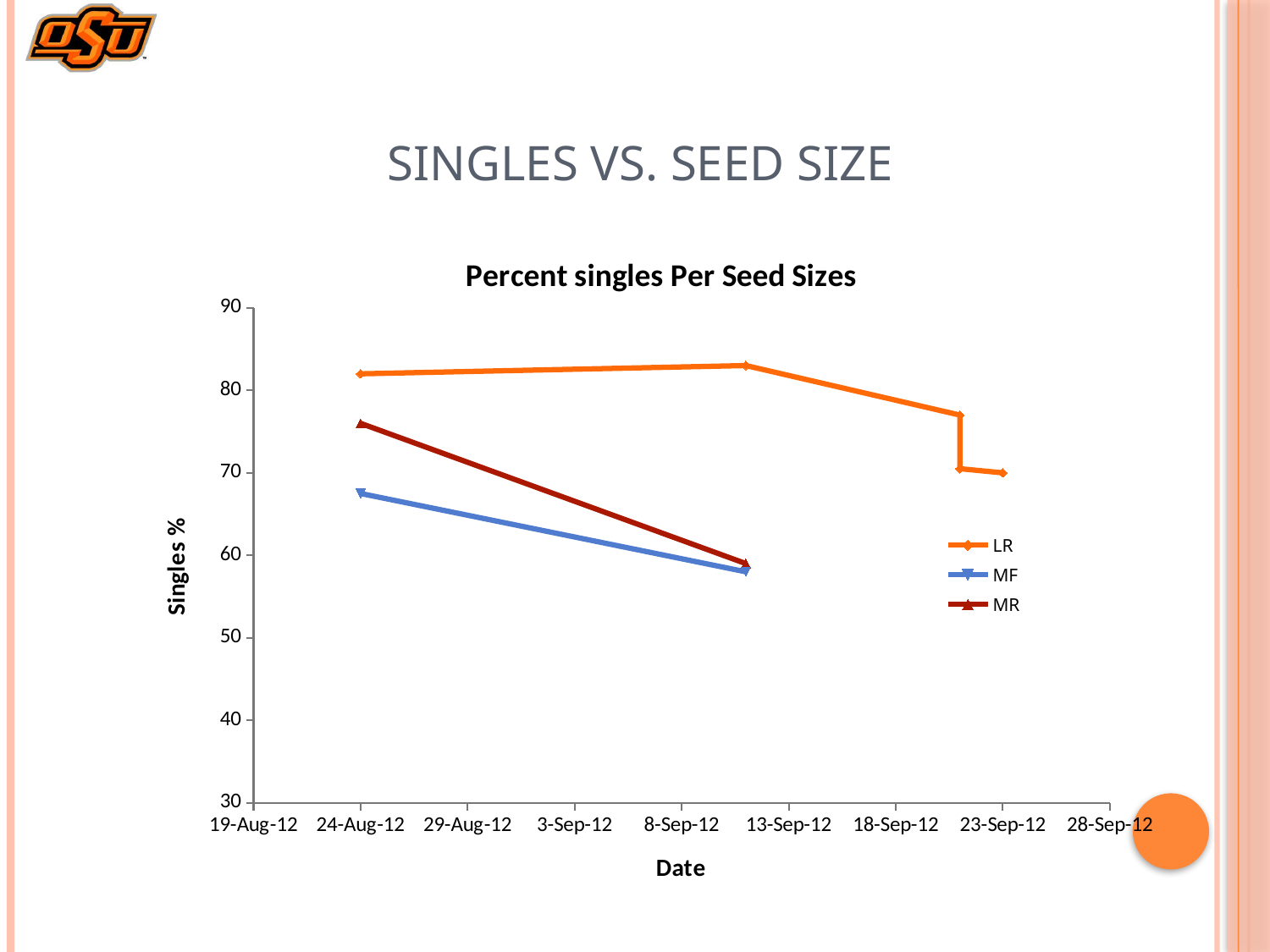
Which series has the lowest value on 24-Aug-12? MF What is the label of the y axis? Singles % What kind of chart is shown on the slide? line chart How many series does the legend list? 3 On 24-Aug-12, which is larger, the value for MR or the value for MF? MR Is the value for LR on 24-Aug-12 greater or less than 80? greater Which series has the highest value on 24-Aug-12? LR Is the value for MR on 24-Aug-12 greater or less than 70? greater What is the title of the chart? Percent singles Per Seed Sizes Do the values for the MF series rise or fall over time? fall How many data points does the MR series have? 2 Is the value for MF on 24-Aug-12 greater or less than 70? less